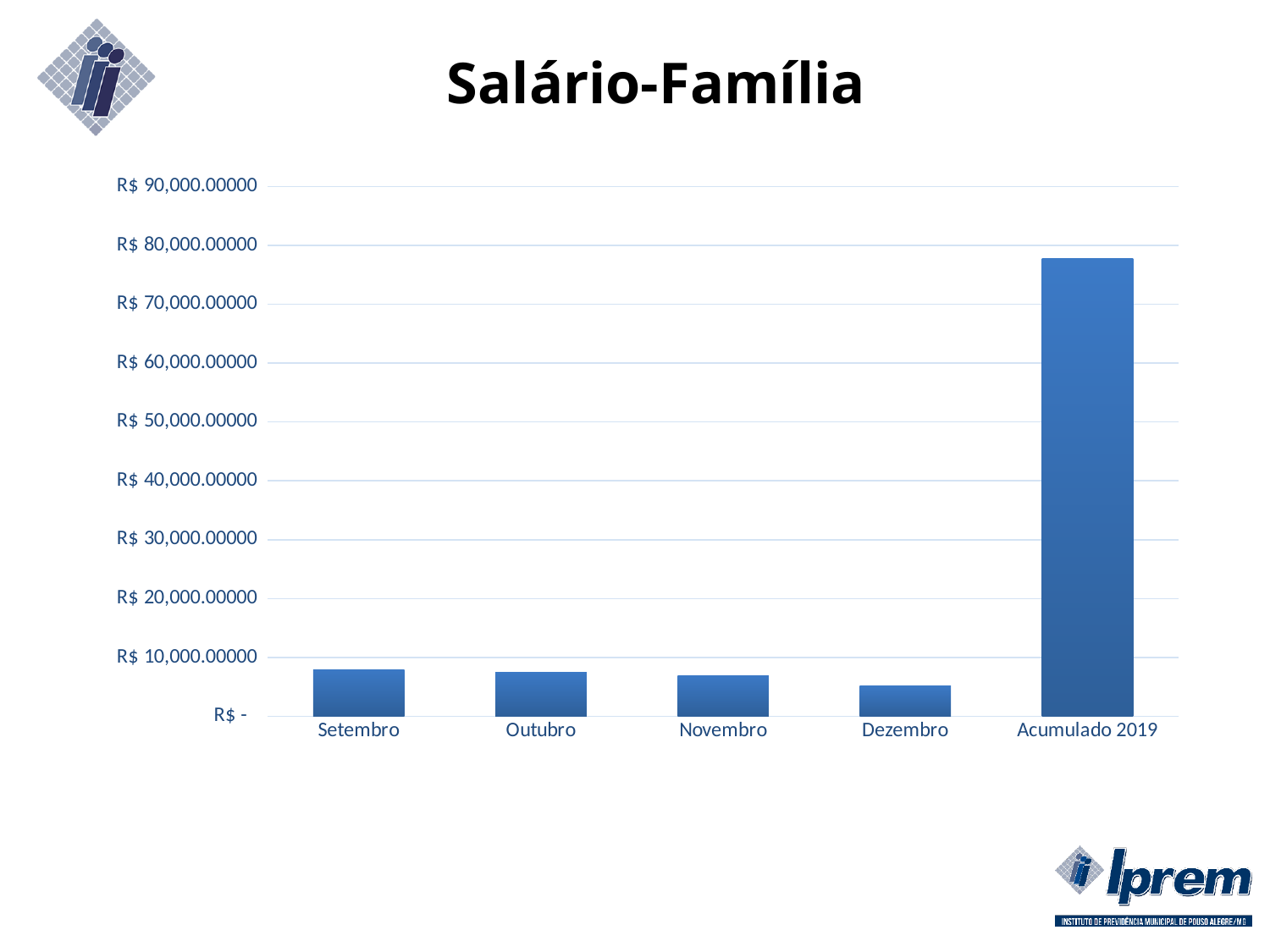
Which category has the highest value in the chart? Acumulado 2019 Do the monthly values rise or fall from Setembro to Dezembro? fall How many categories are shown on the x axis of the chart? 5 Which category has the lowest value in the chart? Dezembro What kind of chart is shown on the slide? bar chart What is the title of the slide containing the chart? Salário-Família Is the value for Acumulado 2019 greater or less than R$ 80,000.00000? less Is the value for Setembro greater or less than R$ 10,000.00000? less Is the value for Dezembro greater or less than R$ 10,000.00000? less Which is larger, the value for Novembro or the value for Dezembro? Novembro Which is larger, the value for Setembro or the value for Dezembro? Setembro